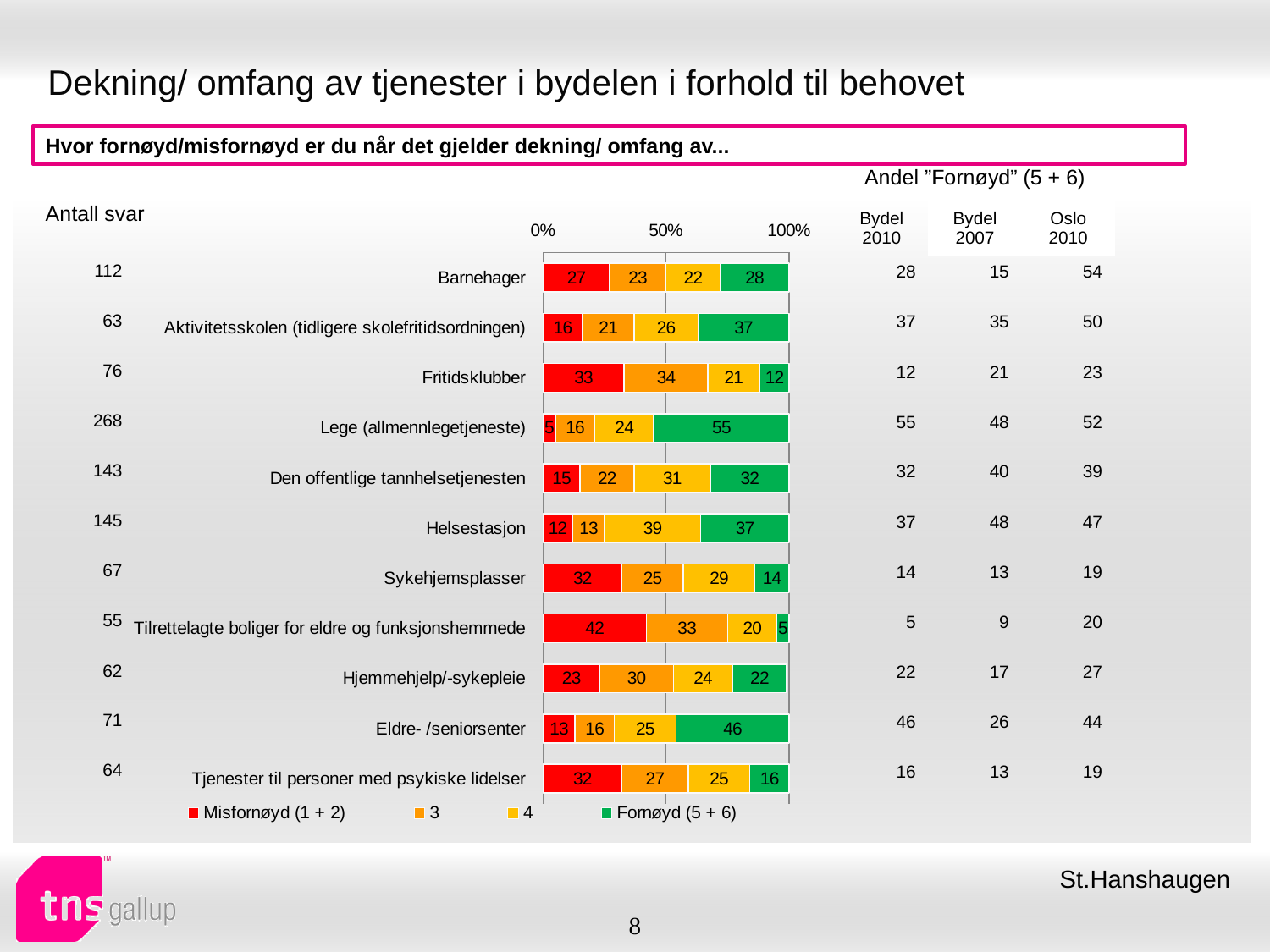
What kind of chart is shown on the slide? Stacked bar chart How many series does the legend list? 4 Which category has the lowest Fornøyd (5 + 6) value? Tilrettelagte boliger for eldre og funksjonshemmede What is the value of the Fornøyd (5 + 6) segment for Lege (allmennlegetjeneste)? 55 How many categories are shown in the bar chart? 11 Which category has the highest Fornøyd (5 + 6) value? Lege (allmennlegetjeneste) What is the total of the stacked bar for Barnehager? 100 Which category has the highest Misfornøyd (1 + 2) value? Tilrettelagte boliger for eldre og funksjonshemmede What is the difference between the Fornøyd (5 + 6) values for Eldre- /seniorsenter and Fritidsklubber? 34 What is the value of the Misfornøyd (1 + 2) segment for Tilrettelagte boliger for eldre og funksjonshemmede? 42 What is the value of the '3' segment for Fritidsklubber? 34 Which has the larger Misfornøyd (1 + 2) value, Barnehager or Hjemmehjelp/-sykepleie? Barnehager